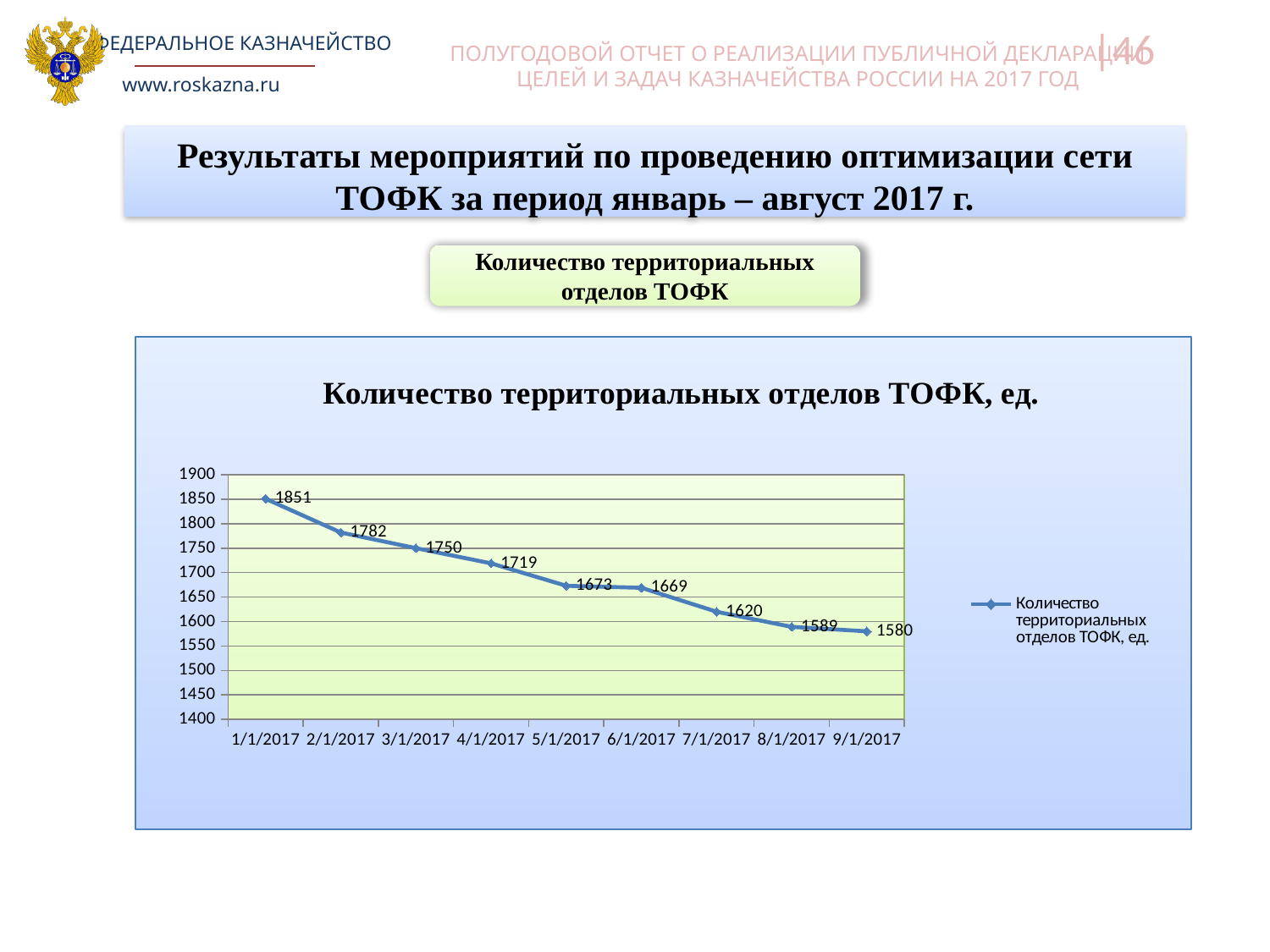
Which date has the lowest value? 9/1/2017 Which is larger, the value for 3/1/2017 or the value for 4/1/2017? 3/1/2017 What is the value for 1/1/2017? 1851 What is the difference between the values for 1/1/2017 and 9/1/2017? 271 What is the value for 5/1/2017? 1673 Do the values rise or fall from 1/1/2017 to 9/1/2017? fall What is the value for 9/1/2017? 1580 What kind of chart is shown on the slide? line chart How many data points are plotted on the chart? 9 Which date has the highest value? 1/1/2017 What is the difference between the values for 6/1/2017 and 7/1/2017? 49 Is the value for 2/1/2017 greater or less than 1800? less